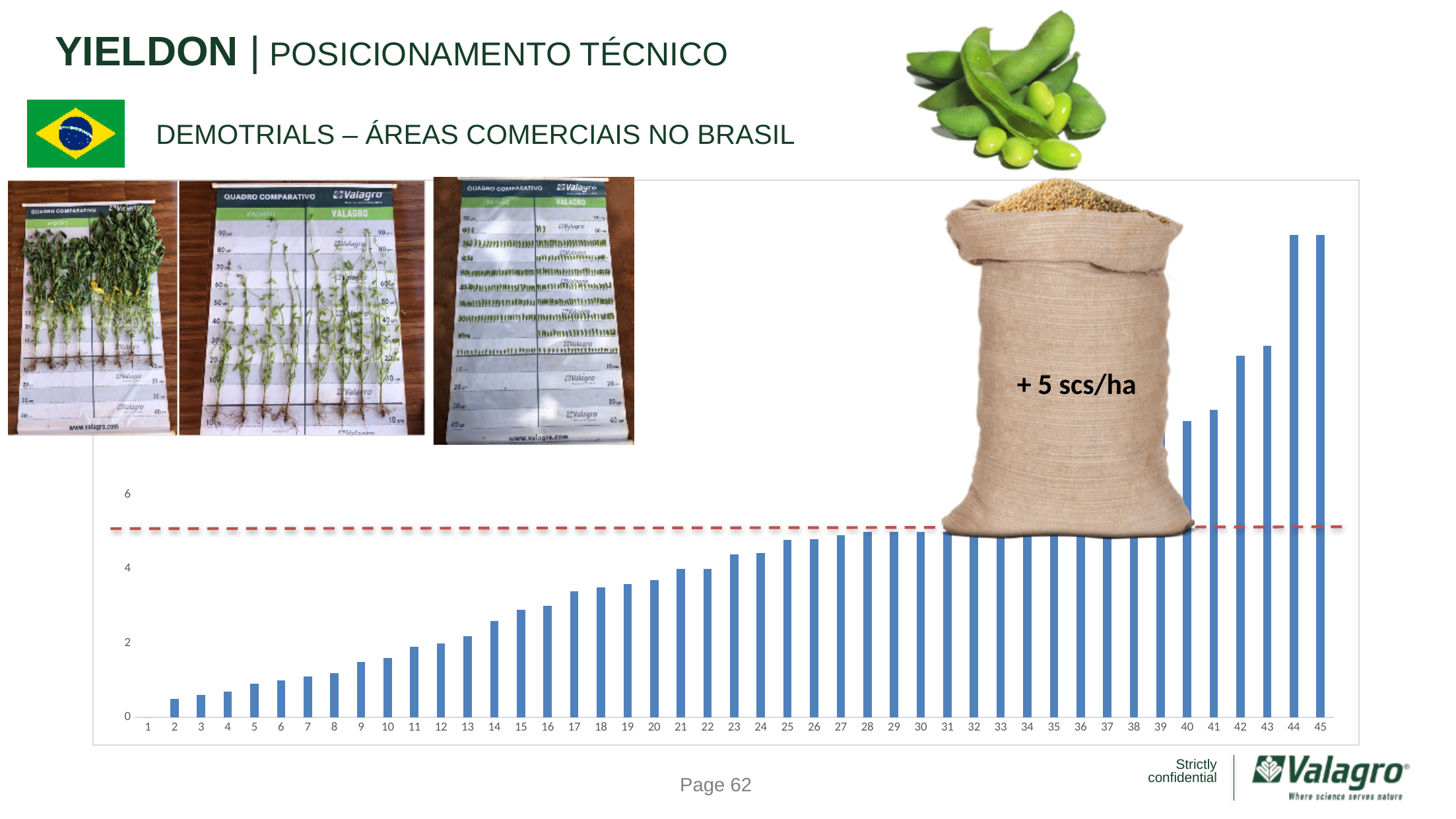
Is the value for category 40 greater or less than 6? greater Which has the larger value, category 30 or category 40? 40 Is the value for category 45 greater or less than 6? greater What kind of chart is shown on the slide? bar chart Do the bar values rise or fall from left to right along the x axis? rise Is the value for category 30 greater or less than 4? greater Which has the larger value, category 12 or category 24? 24 What text label is printed on the sack image overlaid on the chart? + 5 scs/ha How many categories are shown on the x axis of the bar chart? 45